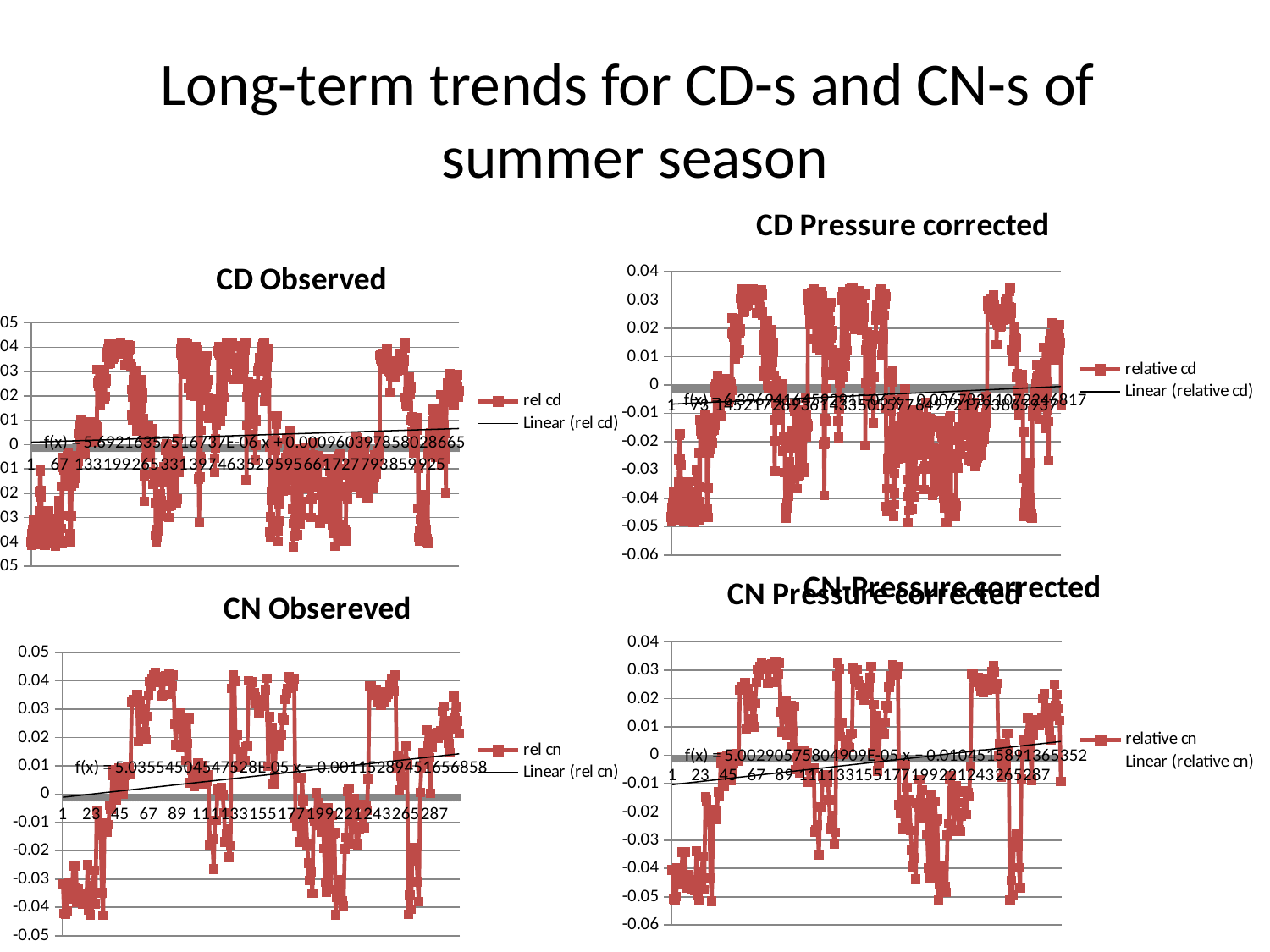
How many series does the legend of the "CN Obsereved" chart list? 2 In the "CN Pressure corrected" chart, is the highest value of the relative cn series greater or less than 0.04? less What is the lowest value shown on the y axis of the "CN Obsereved" chart? -0.05 What are the legend entries of the "CN Obsereved" chart? rel cn, Linear (rel cn) In the "CN Obsereved" chart, is the highest value of the rel cn series greater or less than 0.05? less In the "CD Pressure corrected" chart, is the lowest value of the relative cd series greater or less than -0.06? greater In the "CD Observed" chart, does the linear trendline rise or fall along the x axis? rise What kind of chart is the "CD Observed" chart? line chart How many series does the legend of the "CD Pressure corrected" chart list? 2 What are the legend entries of the "CN Pressure corrected" chart? relative cn, Linear (relative cn) How many charts are shown on the slide? 4 In the "CN Pressure corrected" chart, does the linear trendline rise or fall along the x axis? rise